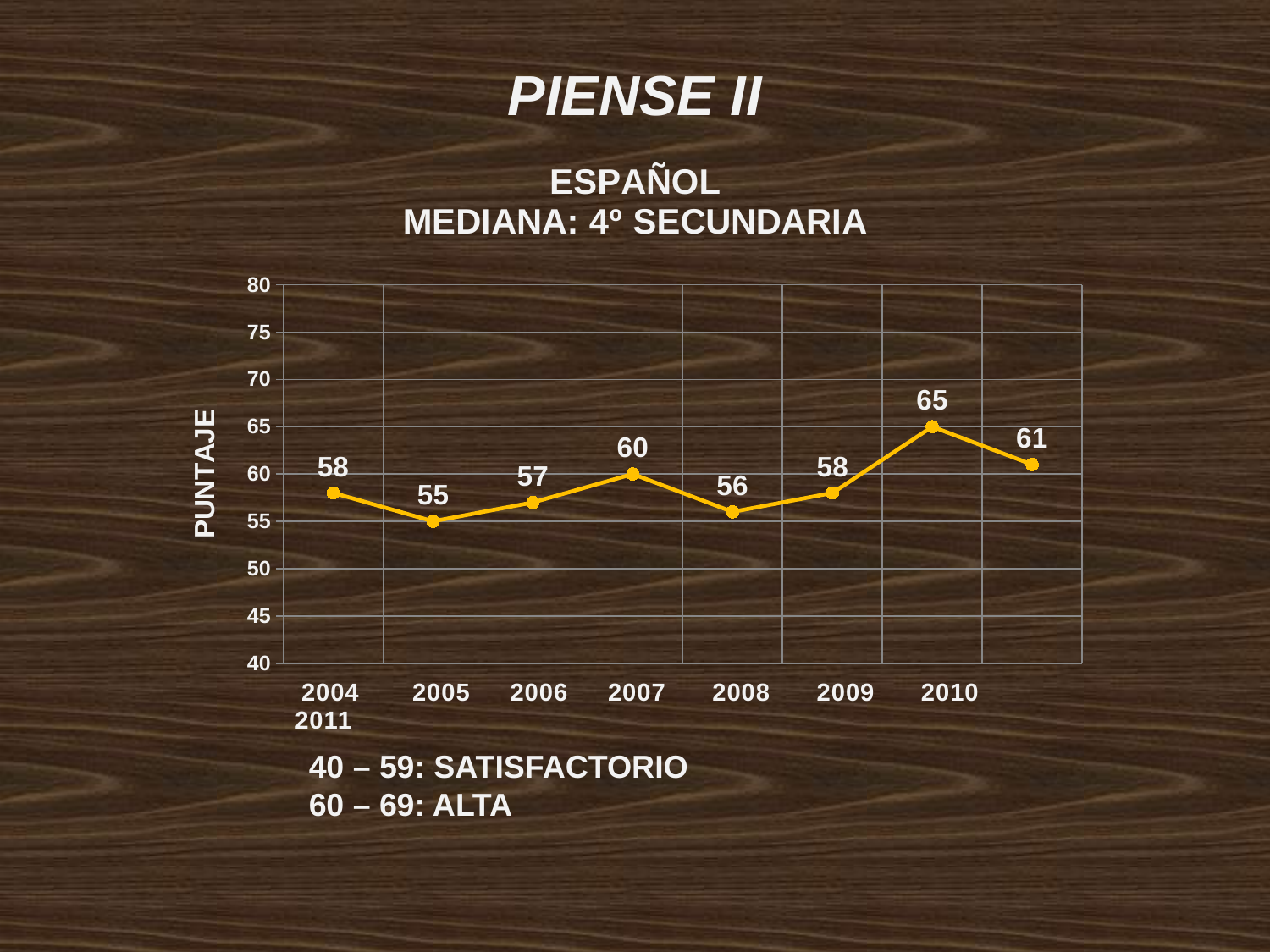
What is the value for 2005? 55 What is the difference between the values for 2010 and 2005? 10 Which year has the highest value? 2010 What is the label on the vertical axis? PUNTAJE Does the value rise or fall from 2009 to 2010? rise How many data points are plotted on the line? 8 What is the value for 2007? 60 What kind of chart is shown? line chart Is the value for 2010 greater or less than 60? greater Which year has the lowest value? 2005 What is the value for 2010? 65 Which is larger, the value for 2008 or the value for 2009? 2009